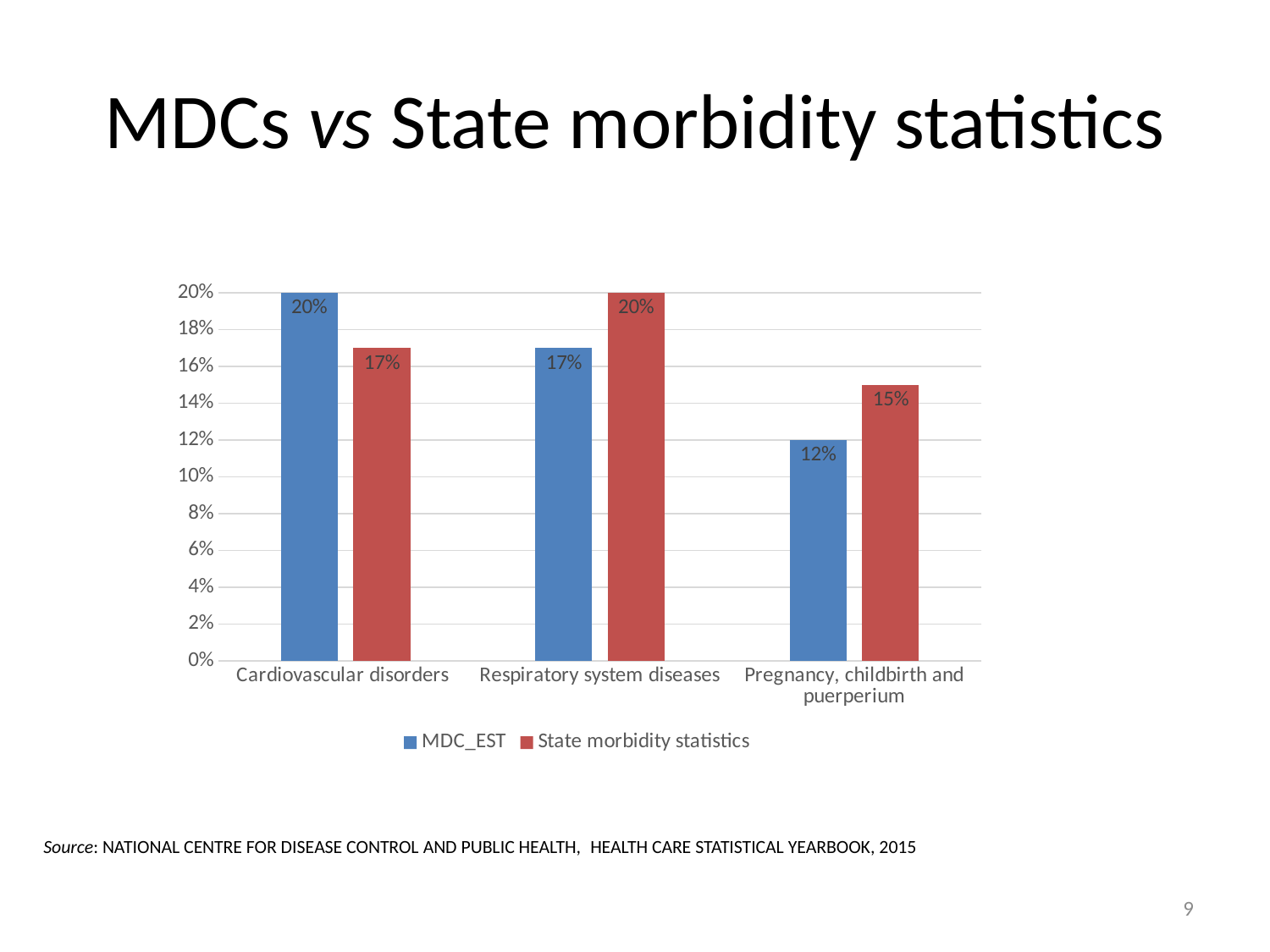
How many categories are shown on the x axis? 3 For Cardiovascular disorders, which is larger: MDC_EST or State morbidity statistics? MDC_EST What is the State morbidity statistics value for Cardiovascular disorders? 17% Which category has the highest State morbidity statistics value? Respiratory system diseases What is the difference between the State morbidity statistics value and the MDC_EST value for Pregnancy, childbirth and puerperium? 3% What is the State morbidity statistics value for Respiratory system diseases? 20% What is the MDC_EST value for Pregnancy, childbirth and puerperium? 12% Which category has the lowest MDC_EST value? Pregnancy, childbirth and puerperium What kind of chart is shown on the slide? Bar chart How many series does the legend list? 2 What is the MDC_EST value for Cardiovascular disorders? 20% What colour are the State morbidity statistics bars? Red